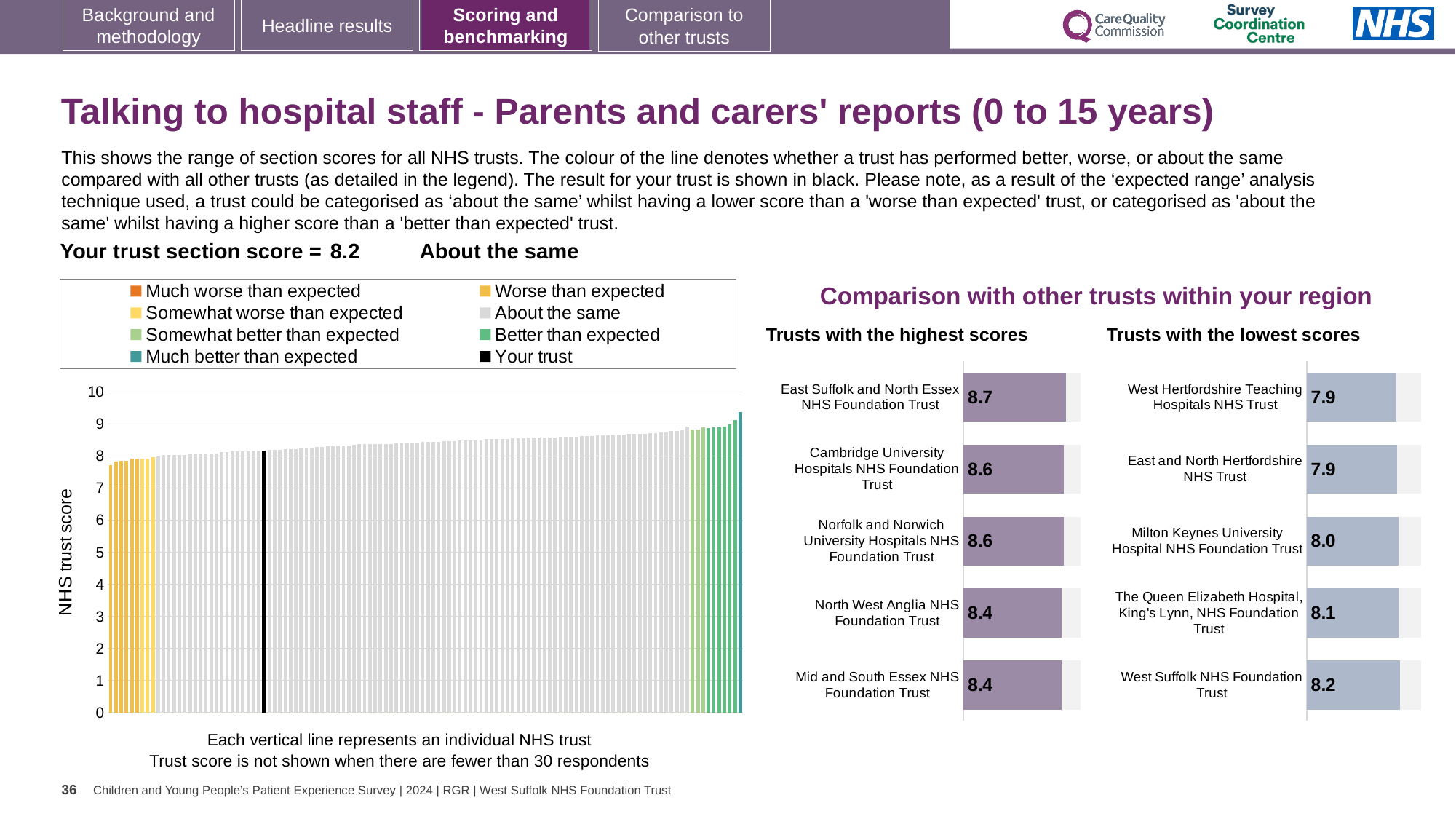
What is the y-axis label of the large chart on the left? NHS trust score In the 'Trusts with the lowest scores' chart, which has the larger score: Milton Keynes University Hospital NHS Foundation Trust or The Queen Elizabeth Hospital, King's Lynn, NHS Foundation Trust? The Queen Elizabeth Hospital, King's Lynn, NHS Foundation Trust In the 'Trusts with the highest scores' chart, what is the score for North West Anglia NHS Foundation Trust? 8.4 In the 'Trusts with the lowest scores' chart, what is the score for Milton Keynes University Hospital NHS Foundation Trust? 8.0 In the 'Trusts with the lowest scores' chart, which trust has the highest score? West Suffolk NHS Foundation Trust What kind of chart is the large chart on the left showing NHS trust scores? Bar chart In the 'Trusts with the highest scores' chart, what is the score for East Suffolk and North Essex NHS Foundation Trust? 8.7 How many trusts are shown in the 'Trusts with the highest scores' chart? 5 In the 'Trusts with the highest scores' chart, what is the difference between the scores of East Suffolk and North Essex NHS Foundation Trust and Mid and South Essex NHS Foundation Trust? 0.3 In the 'Trusts with the highest scores' chart, which trust has the highest score? East Suffolk and North Essex NHS Foundation Trust In the large chart on the left, is the value of the tallest bar greater or less than 9? greater In the 'Trusts with the lowest scores' chart, what is the score for West Suffolk NHS Foundation Trust? 8.2